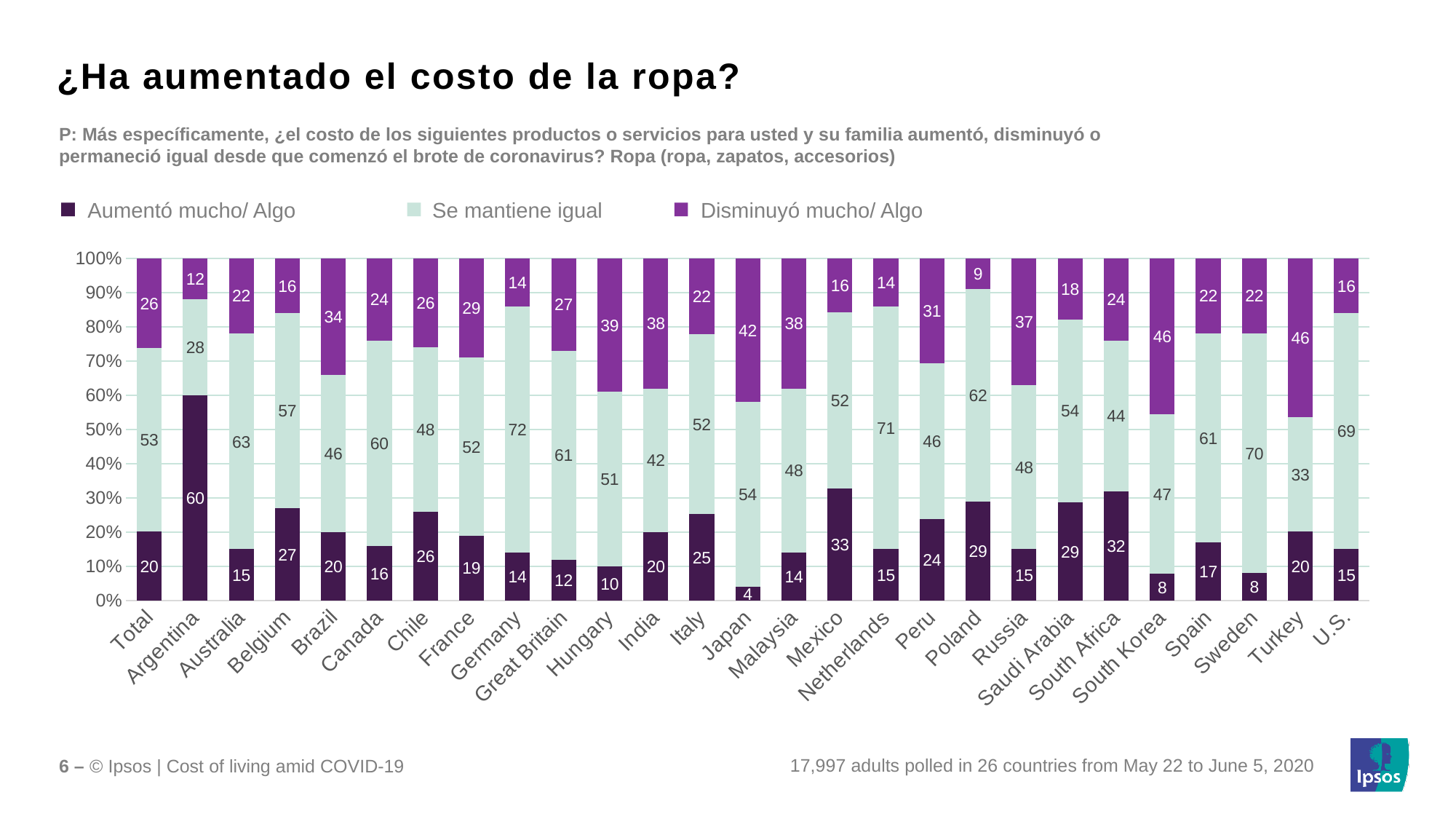
Which country has the highest value for 'Aumentó mucho/ Algo'? Argentina What is the value of 'Disminuyó mucho/ Algo' for Japan? 42 Which is larger: the 'Disminuyó mucho/ Algo' value for Hungary or for Brazil? Hungary What is the difference between the 'Aumentó mucho/ Algo' values for Mexico and Total? 13 Which country has the lowest value for 'Aumentó mucho/ Algo'? Japan What is the title of the chart on the slide? ¿Ha aumentado el costo de la ropa? What is the value of 'Aumentó mucho/ Algo' for Argentina? 60 How many series does the legend list? 3 Which country has the lowest value for 'Disminuyó mucho/ Algo'? Poland What is the value of 'Se mantiene igual' for Germany? 72 What kind of chart is shown on the slide? Stacked bar chart How many categories are shown on the x axis? 27